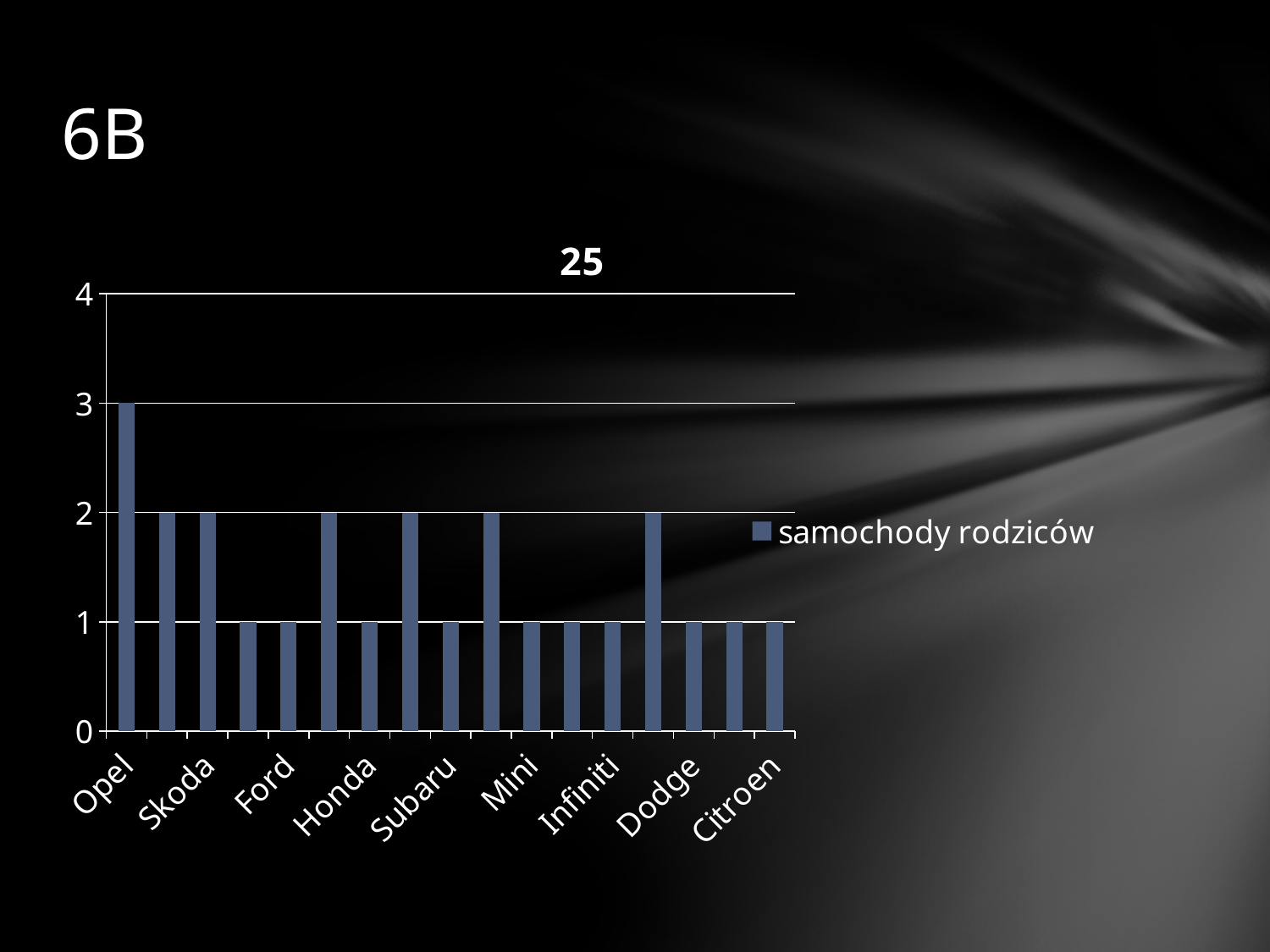
What is the value for Ford? 1 What is the value for Citroen? 1 Which is larger, the value for Skoda or the value for Honda? Skoda What is the difference between the values for Opel and Skoda? 1 How many series does the legend list? 1 How many bars are plotted in the chart? 17 What is the value for Opel? 3 What is the title of the chart? 25 What series name does the legend show? samochody rodziców Which labelled category has the highest value? Opel What is the value for Skoda? 2 What type of chart is shown on the slide? bar chart